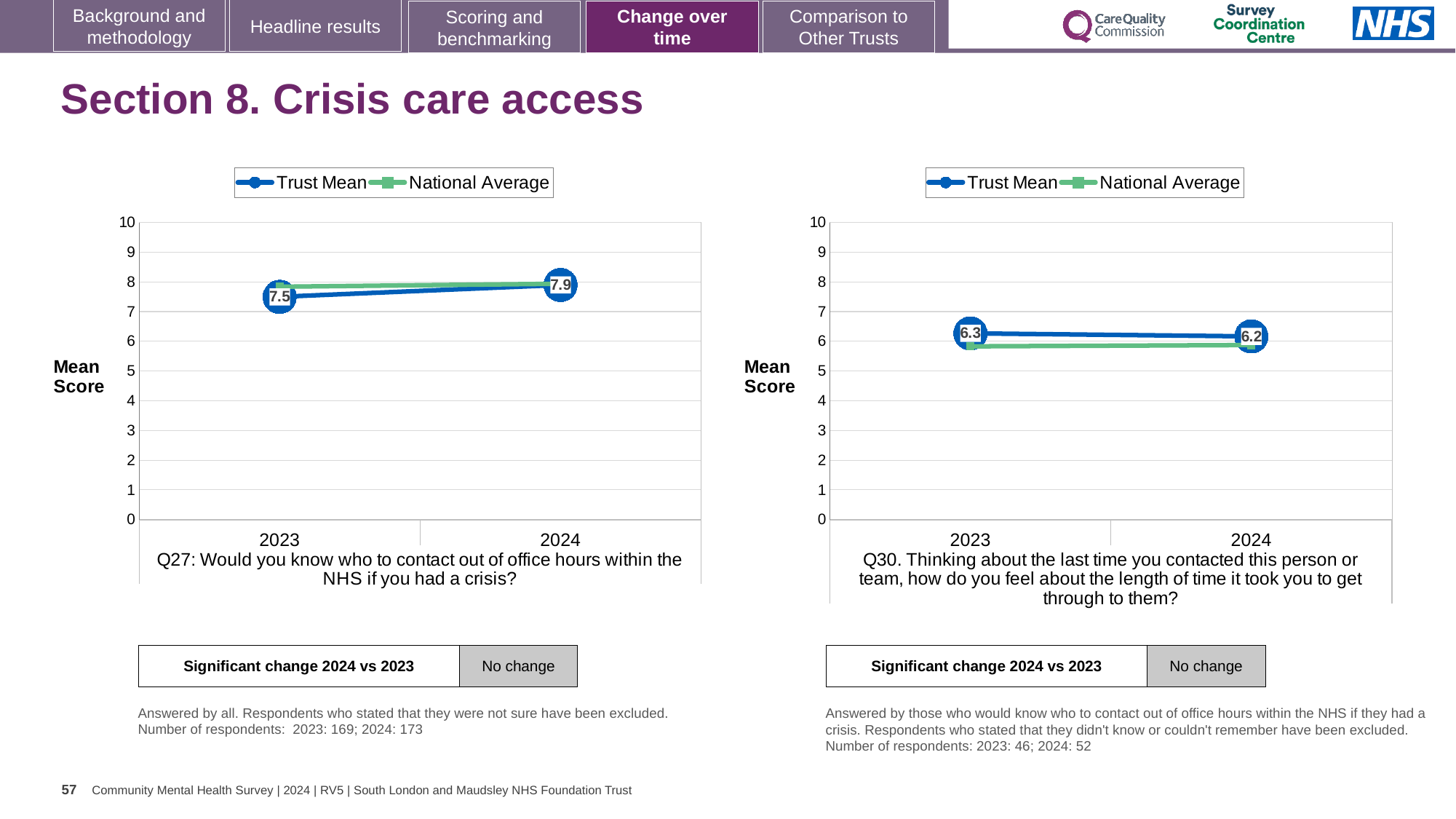
In the Q27 chart on the left, by how much did the Trust Mean change from 2023 to 2024? 0.4 What kind of chart is the Q27 chart on the left? line chart How many series does the legend of the Q30 chart on the right list? 2 How many years are plotted on the x axis of the Q27 chart on the left? 2 In the Q30 chart on the right, what is the Trust Mean score for 2024? 6.2 In the Q27 chart on the left, what is the Trust Mean score for 2024? 7.9 In the Q27 chart on the left, what is the Trust Mean score for 2023? 7.5 In the Q30 chart on the right, does the Trust Mean rise or fall from 2023 to 2024? fall In the Q27 chart on the left, does the Trust Mean rise or fall from 2023 to 2024? rise In the Q30 chart on the right, is the Trust Mean or the National Average higher in 2023? Trust Mean In the Q27 chart on the left, is the National Average value for 2023 greater or less than 7? greater In the Q30 chart on the right, what is the Trust Mean score for 2023? 6.3